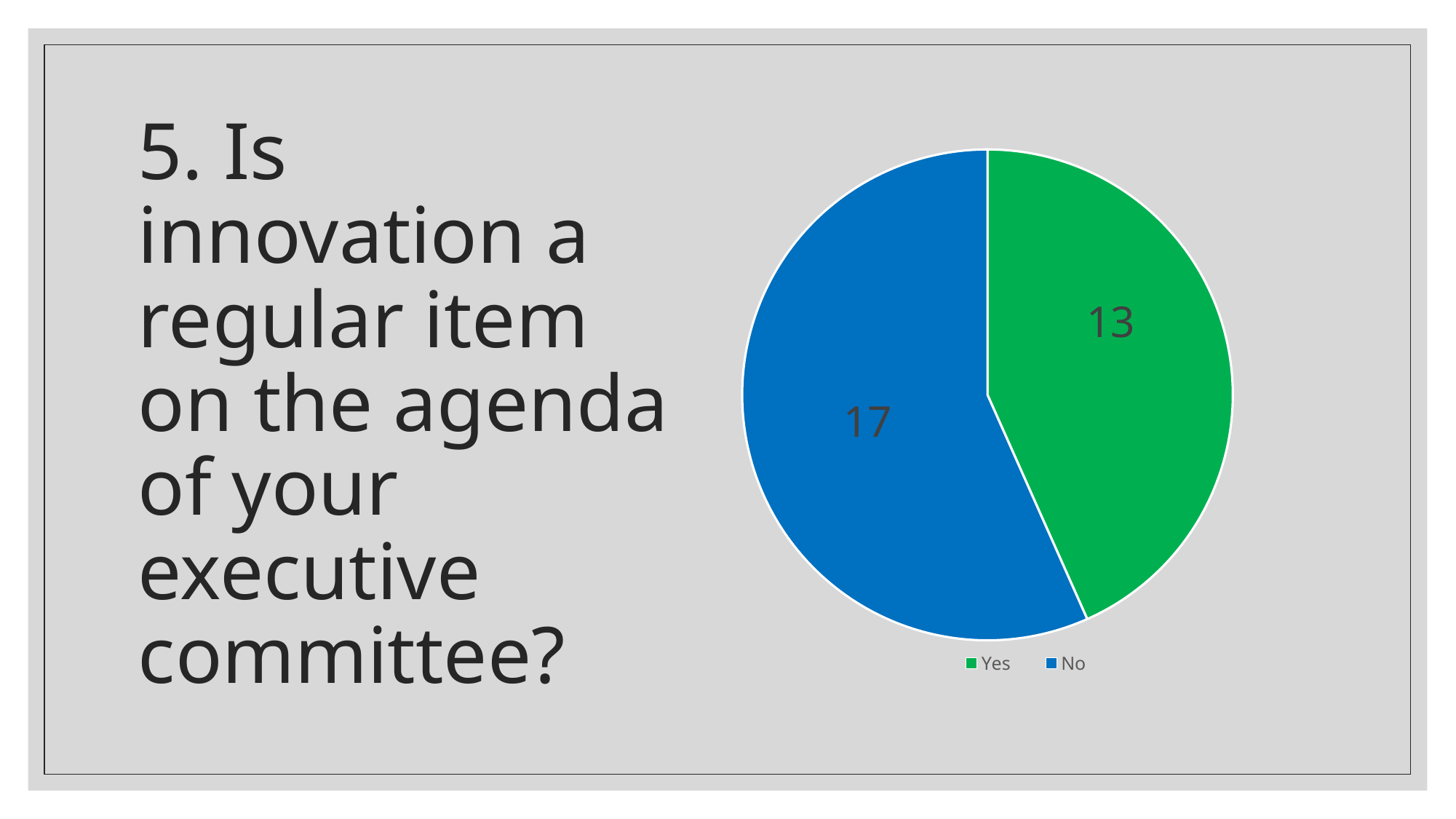
Which category has the largest slice? No What is the total of all slices in the pie chart? 30 What is the difference between the No and Yes values? 4 What is the value for No? 17 What is the value for Yes? 13 Which category has the smallest slice? Yes Which is larger, Yes or No? No What colour is the Yes slice? green What colour is the No slice? blue How many slices does the pie chart have? 2 How many entries does the legend list? 2 What kind of chart is shown on the slide? pie chart